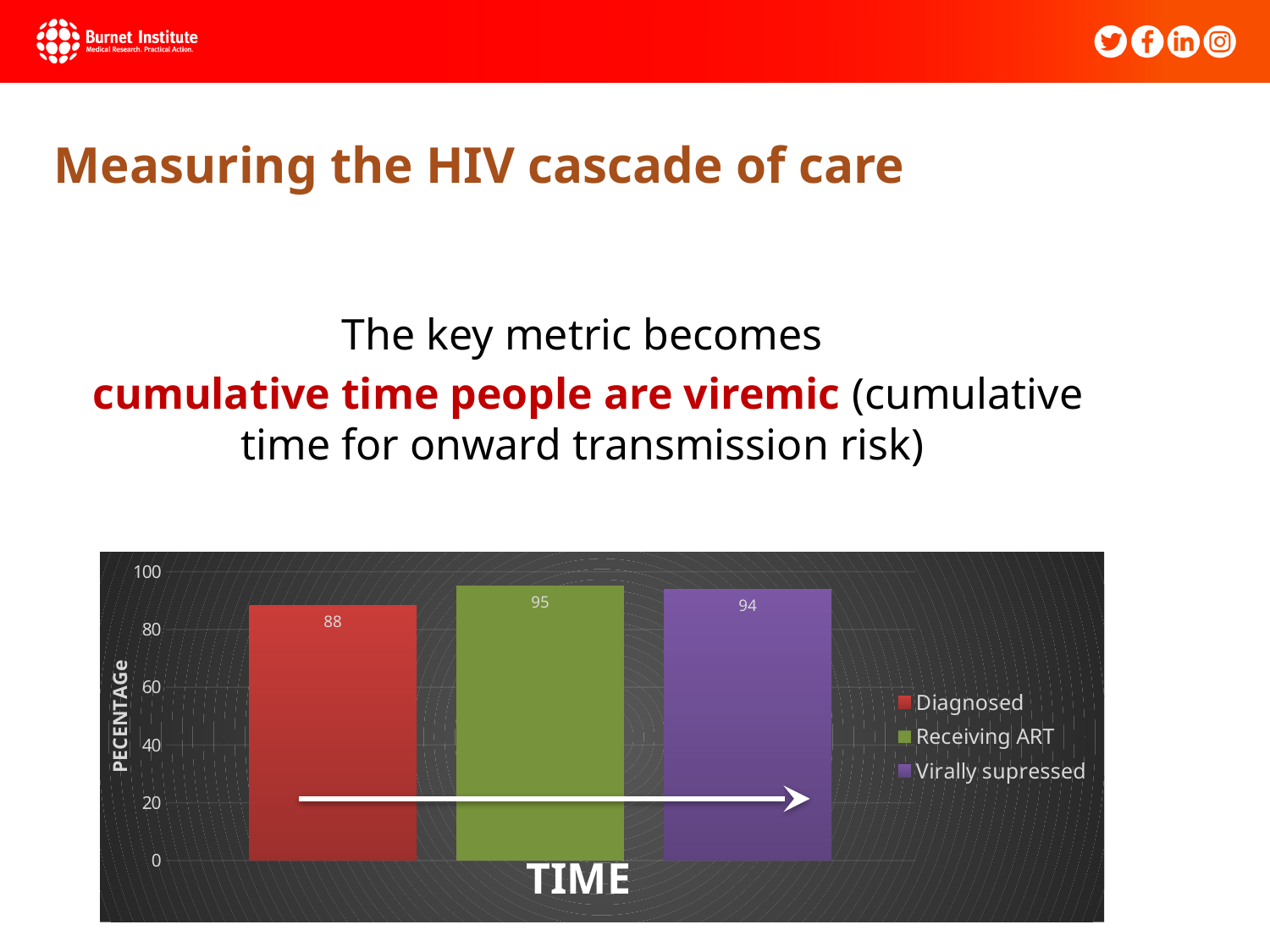
What is the value for Receiving ART? 95 Which series has the lowest value? Diagnosed What is the difference between the Receiving ART value and the Diagnosed value? 7 Is the value for Diagnosed greater or less than 80? greater What is the label on the vertical axis of the chart? PECENTAGe How many bars are plotted in the chart? 3 Which is larger, the value for Diagnosed or the value for Virally supressed? Virally supressed What kind of chart is shown on the slide? bar chart Which series has the highest value? Receiving ART What is the value for Diagnosed? 88 How many series does the legend list? 3 What is the value for Virally supressed? 94